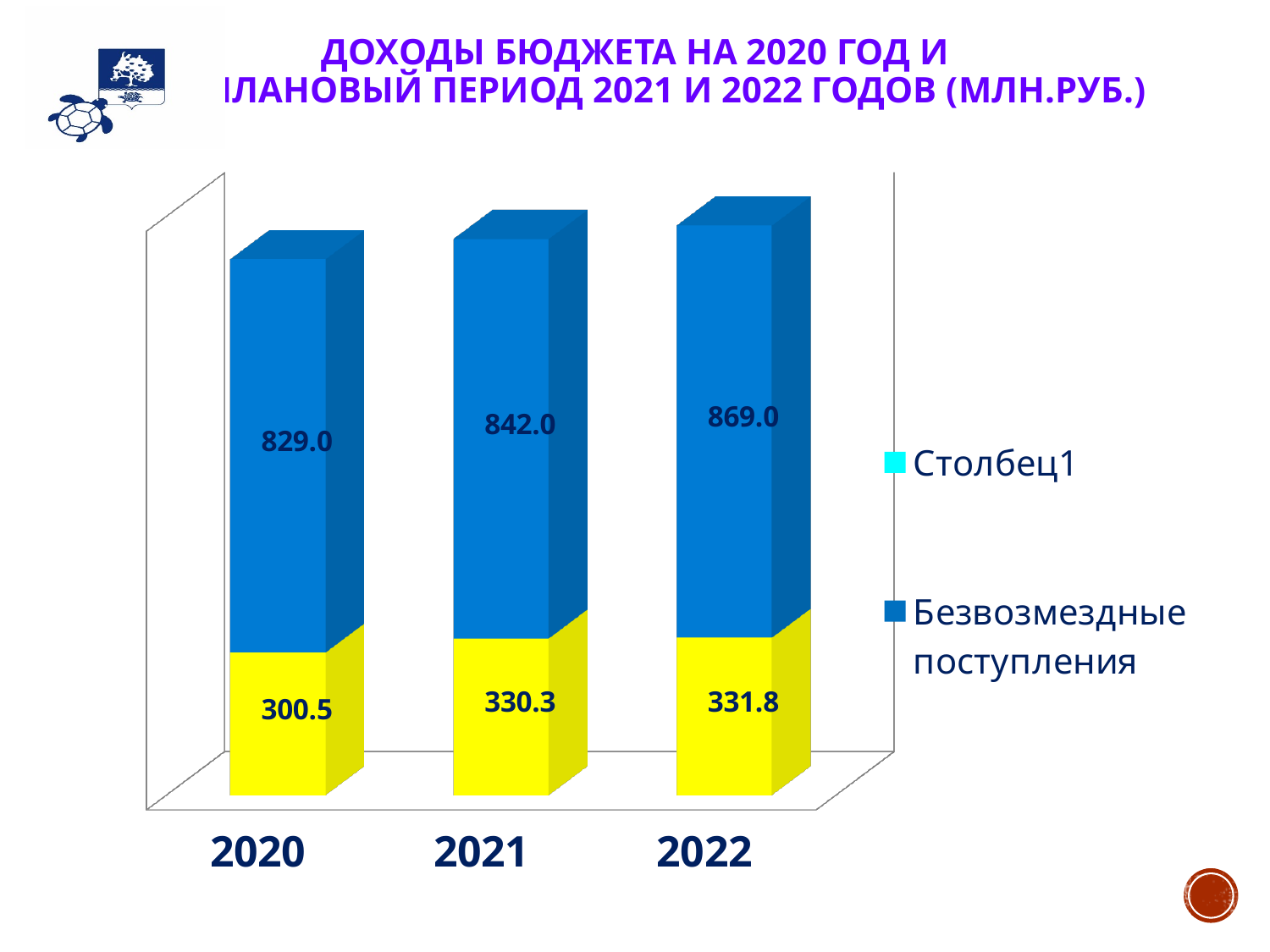
How many series does the chart legend list? 2 What is the value of Безвозмездные поступления for 2020? 829.0 How many years are shown on the x axis of the chart? 3 Which is larger: Безвозмездные поступления in 2021 or in 2020? 2021 Do the values of Безвозмездные поступления rise or fall from 2020 to 2022? Rise What kind of chart is shown on the slide? Stacked bar chart What is the total of the stacked bar for 2022? 1200.8 Which year has the highest value for Безвозмездные поступления? 2022 Which year has the lowest value in the yellow (lower) segment? 2020 By how much does Безвозмездные поступления in 2022 exceed the value in 2020? 40.0 What is the value printed on the yellow (lower) segment of the 2021 bar? 330.3 What is the value of Безвозмездные поступления for 2022? 869.0